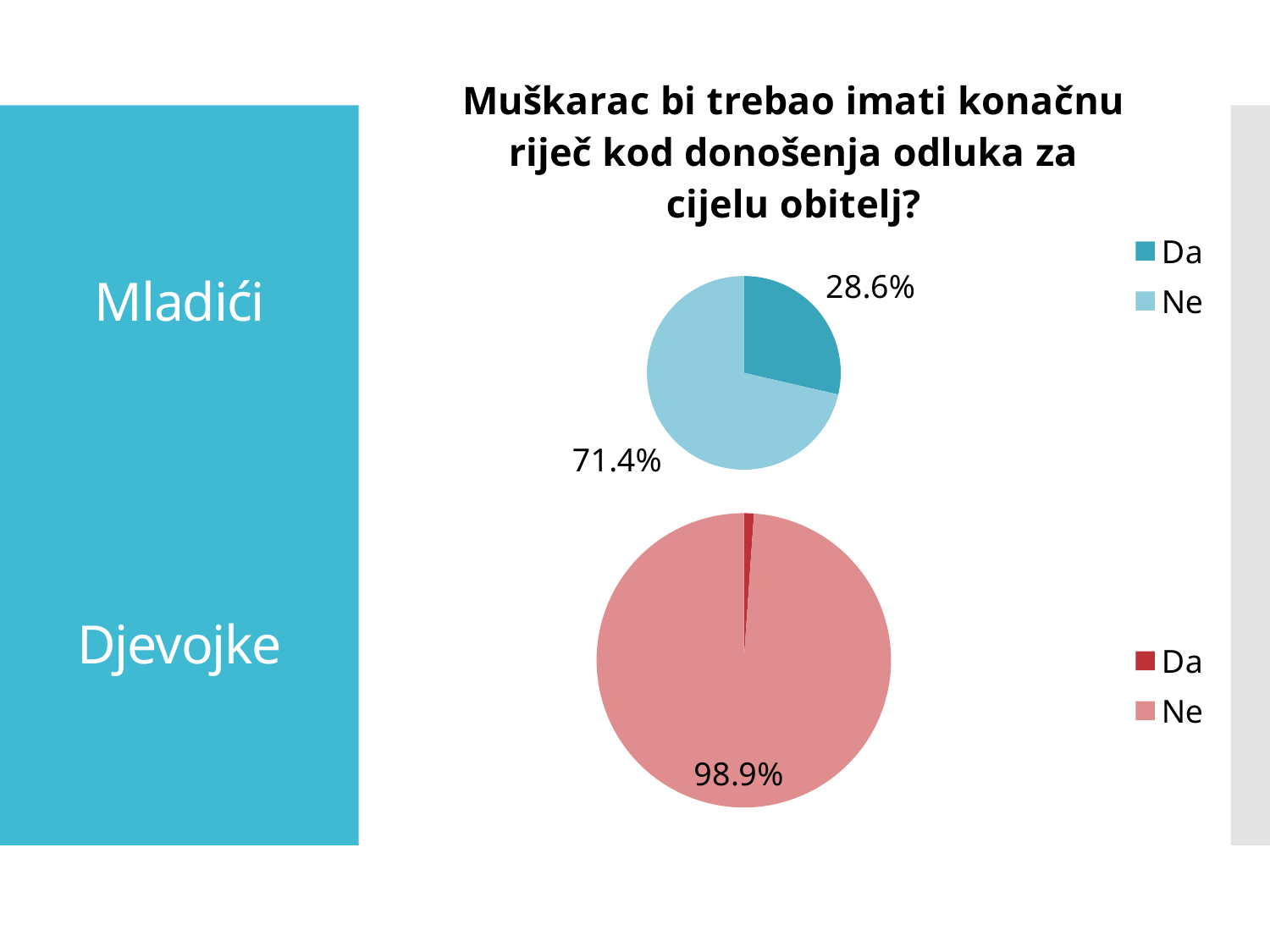
In the top pie chart (Mladići), what share of respondents answered Ne? 71.4% In the top pie chart (Mladići), what is the difference in percentage points between the Ne share and the Da share? 42.8 What colour is the Da slice in the bottom pie chart (Djevojke)? dark red In the top pie chart (Mladići), what share of respondents answered Da? 28.6% What kind of chart is used for the Mladići data on the slide? pie chart What is the title shown above the pie charts? Muškarac bi trebao imati konačnu riječ kod donošenja odluka za cijelu obitelj? Which group's pie chart shows the larger Ne share, Mladići or Djevojke? Djevojke In the bottom pie chart (Djevojke), which answer has the smallest share? Da In the bottom pie chart (Djevojke), what share of respondents answered Ne? 98.9% How many entries does the legend of the bottom pie chart (Djevojke) list? 2 How many slices does the top pie chart (Mladići) have? 2 In the top pie chart (Mladići), which answer has the larger share, Da or Ne? Ne